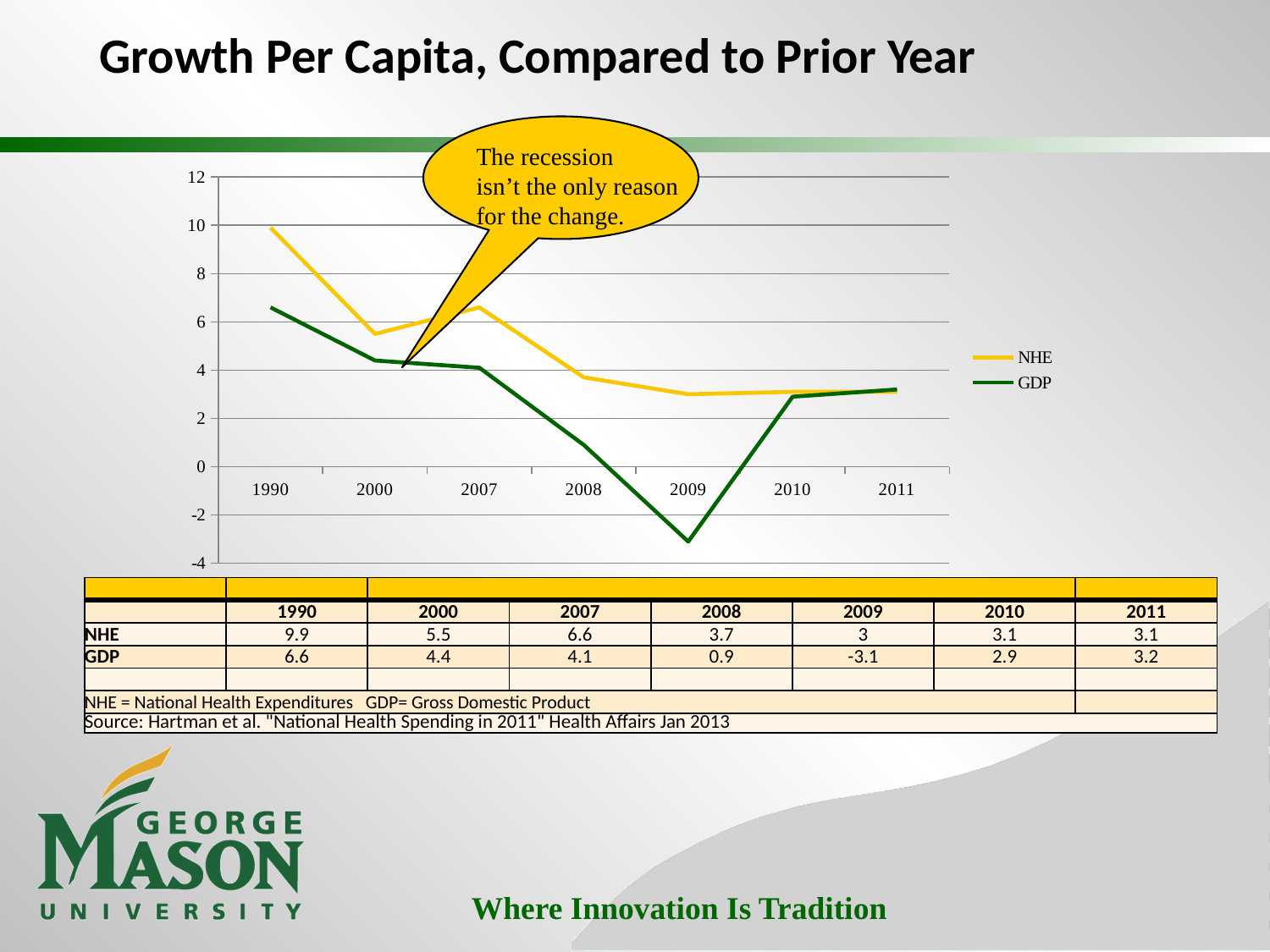
How many series does the chart legend list? 2 In which year is the NHE growth value highest? 1990 What is the GDP growth value for 2009? -3.1 What is the NHE growth value for 2008? 3.7 What is the difference between the NHE and GDP values in 2009? 6.1 Does the NHE line generally rise or fall from 1990 to 2009? fall What kind of chart is shown on the slide? line chart What does the callout bubble on the chart say? The recession isn't the only reason for the change. What is the NHE growth value for 1990? 9.9 In which year is the GDP growth value lowest? 2009 How many years are plotted along the x axis of the chart? 7 Which is larger in 2011, the NHE value or the GDP value? GDP